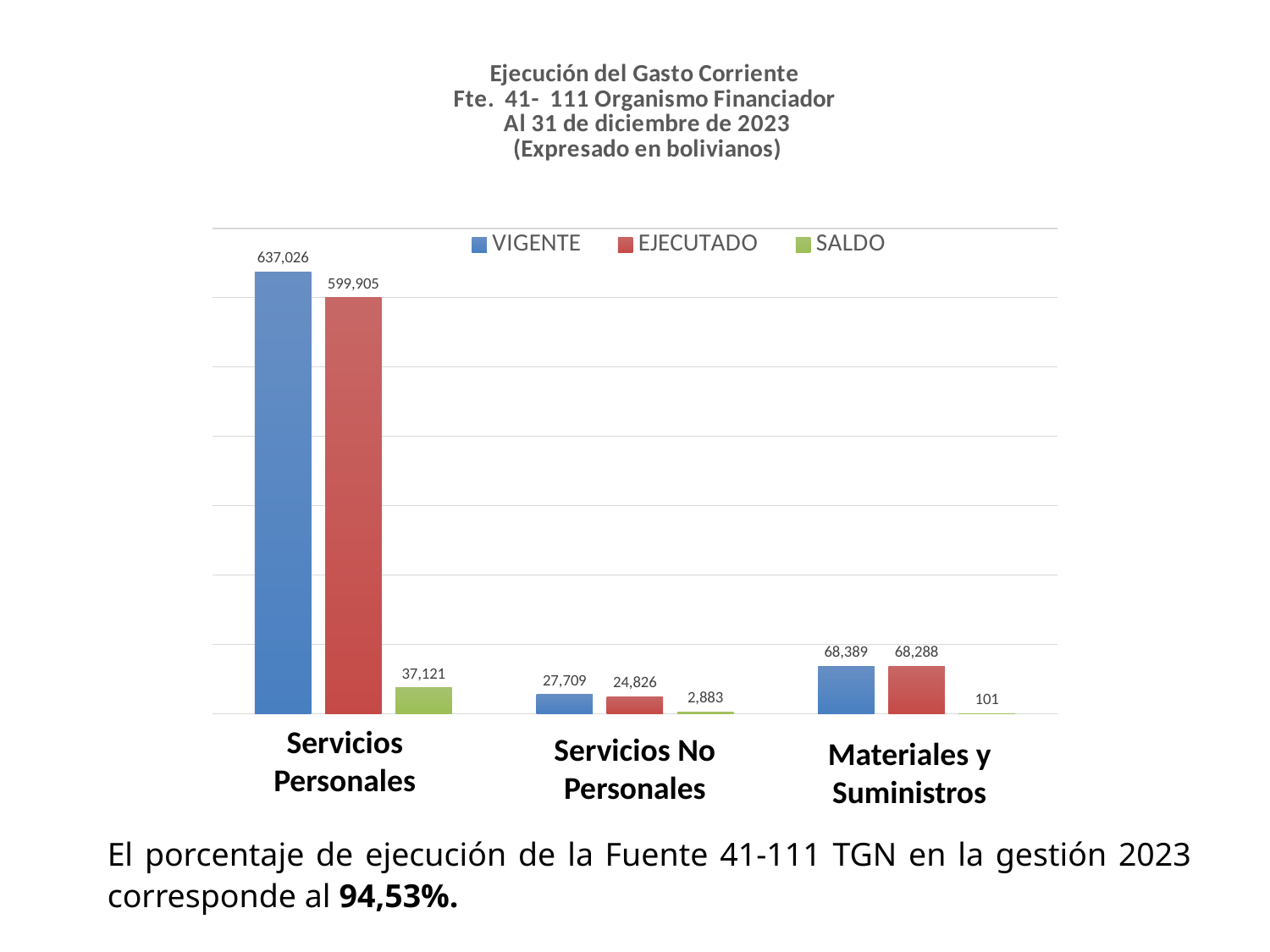
Which category has the highest VIGENTE value? Servicios Personales What is the EJECUTADO value for Servicios No Personales? 24,826 How many series does the legend list? 3 What is the difference between the VIGENTE and EJECUTADO values for Servicios Personales? 37,121 How many categories are shown on the x axis? 3 What kind of chart is shown on the slide? Bar chart What is the VIGENTE value for Servicios Personales? 637,026 Which is larger, the VIGENTE value for Servicios No Personales or the VIGENTE value for Materiales y Suministros? Materiales y Suministros Which series is shown in green in the legend? SALDO Which category has the lowest SALDO value? Materiales y Suministros What is the SALDO value for Materiales y Suministros? 101 What is the EJECUTADO value for Materiales y Suministros? 68,288